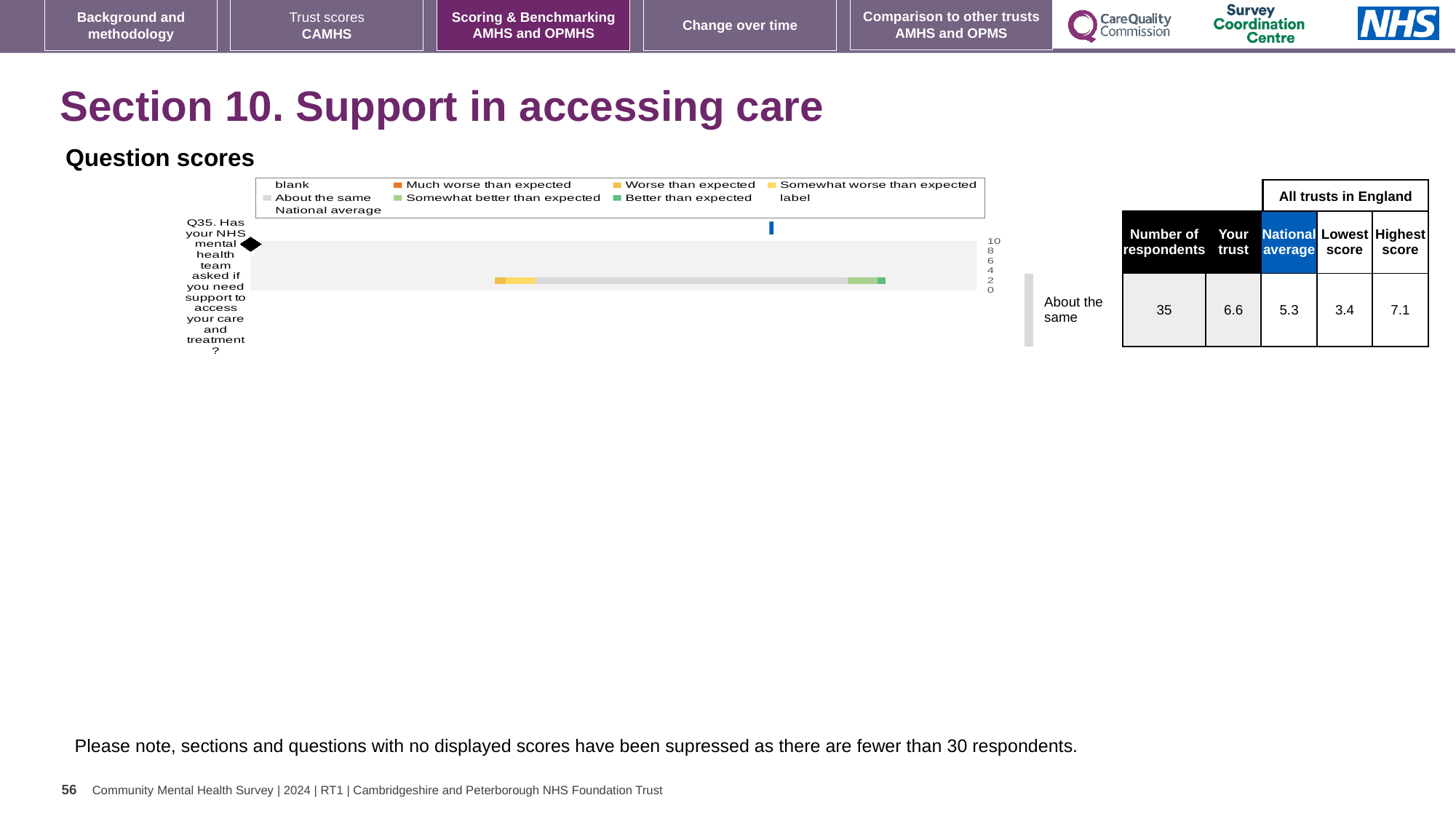
How many questions are plotted in the Question scores chart? 1 Which benchmark category is the trust's Q35 score placed in? About the same How many entries does the legend of the Question scores chart list? 9 What is the national average score for Q35? 5.3 Which is larger for Q35: the trust's score or the national average? the trust's score What is the lowest score among all trusts in England for Q35? 3.4 What is the difference between the highest and lowest scores for Q35 across all trusts in England? 3.7 How many respondents answered Q35? 35 What is the "Your trust" score for Q35 in the Question scores chart? 6.6 Is the trust's score for Q35 greater or less than 4? greater What kind of chart is shown under "Question scores"? bar chart What is the highest score among all trusts in England for Q35? 7.1